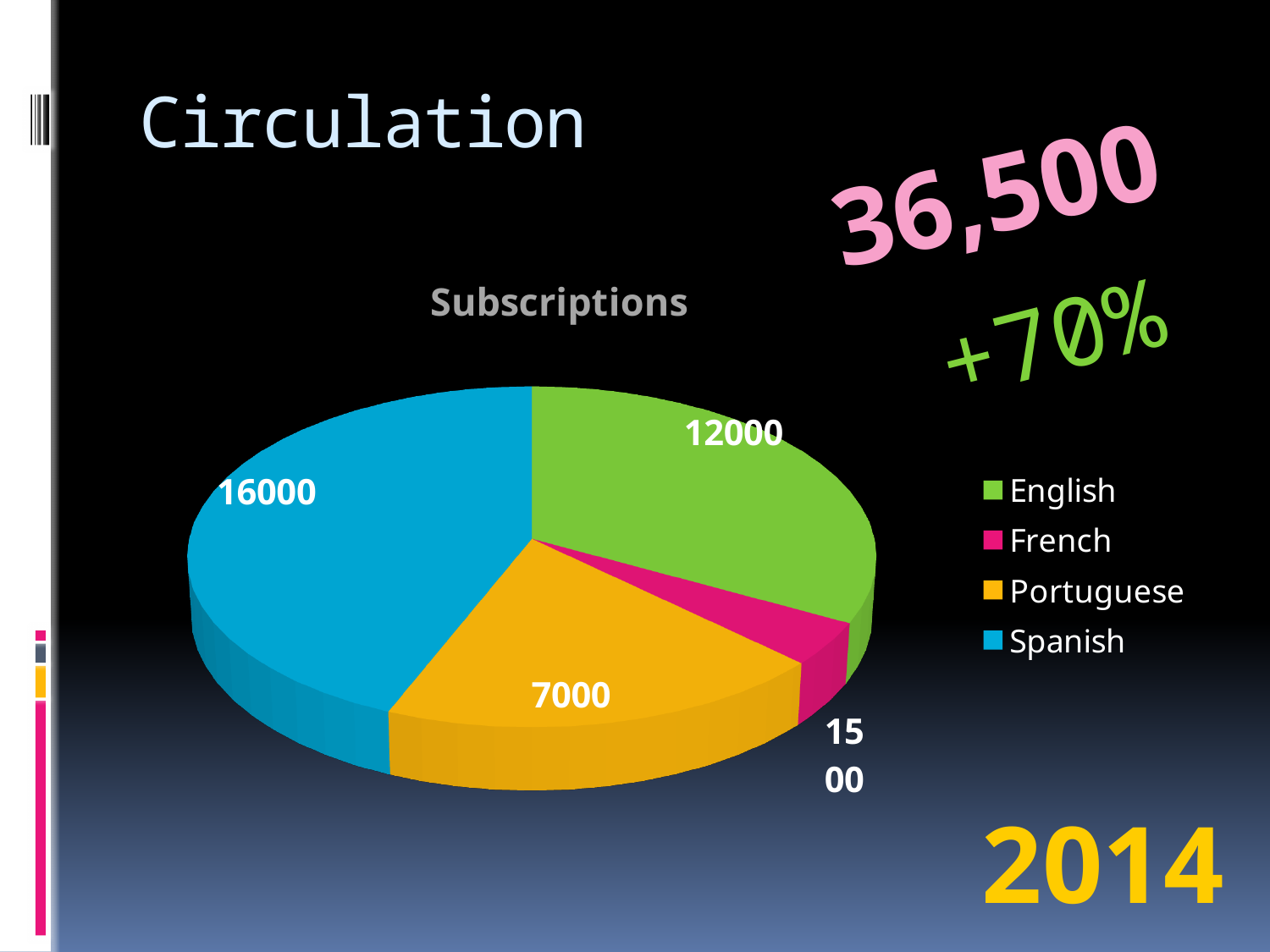
How many entries does the legend list? 4 What is the value for English in the Subscriptions chart? 12000 Which language has the largest number of subscriptions? Spanish What is the title of the chart? Subscriptions Which is larger, the value for Portuguese or the value for English? English Which language has the smallest number of subscriptions? French What is the value for Spanish in the Subscriptions chart? 16000 What is the value for French in the Subscriptions chart? 1500 What kind of chart is shown on the slide? Pie chart How many slices does the Subscriptions pie chart have? 4 What is the difference between the Spanish and English subscription values? 4000 What is the value for Portuguese in the Subscriptions chart? 7000